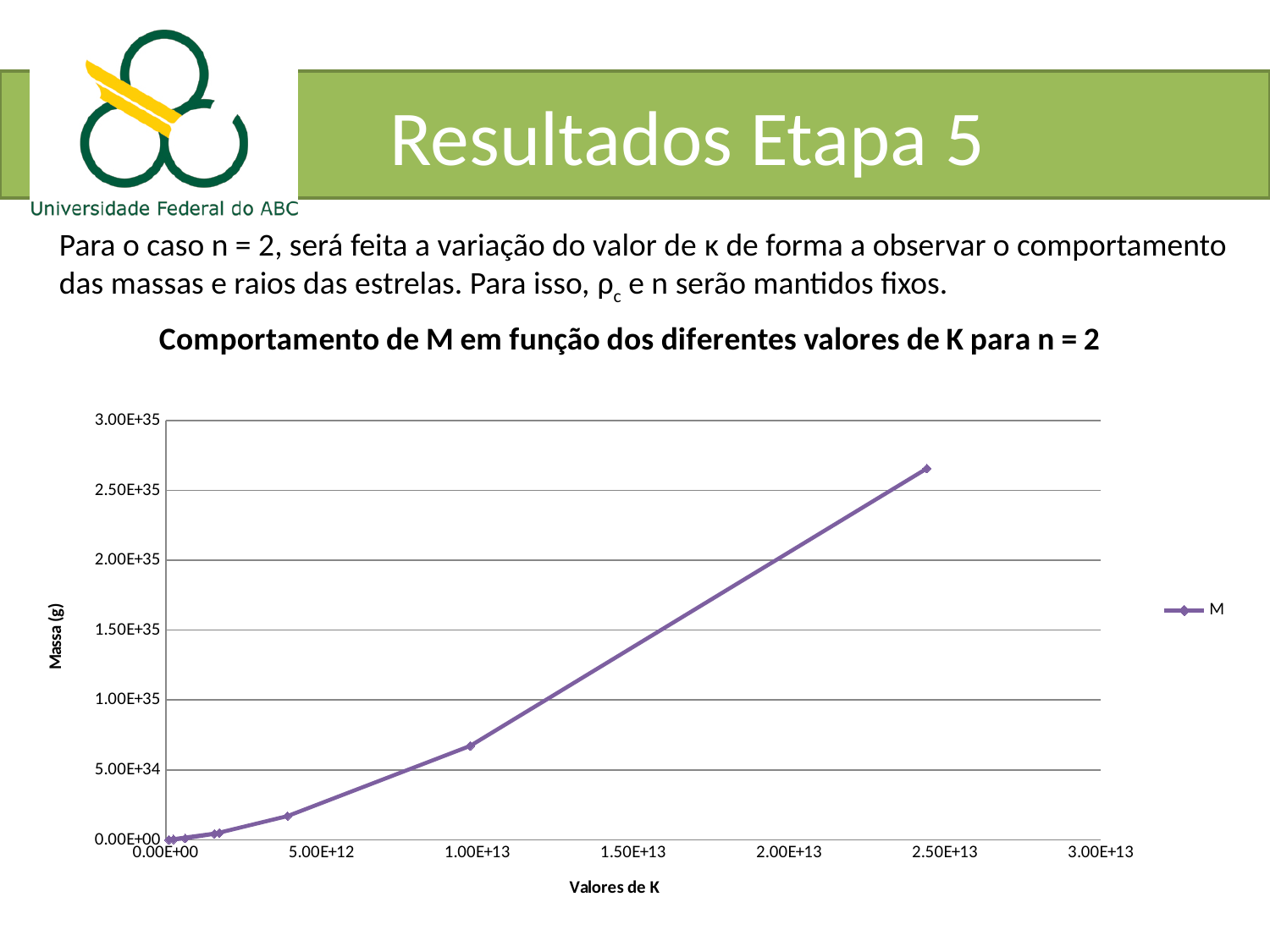
Does the value of M rise or fall as the value of K increases along the x axis? rise Is the value of M at K = 1.00E+13 greater or less than 1.00E+35? less Which plotted point has the highest value of M: the one at the smallest K or the one at the largest K? the one at the largest K Is the value of M at K = 1.00E+13 greater or less than 5.00E+34? greater What is the name of the series shown in the legend? M Is the value of M at the highest plotted K (around 2.50E+13) greater or less than 2.50E+35? greater How many series does the legend list? 1 What kind of chart is shown on the slide? line chart What is the highest tick value shown on the y axis? 3.00E+35 What is the title of the chart? Comportamento de M em função dos diferentes valores de K para n = 2